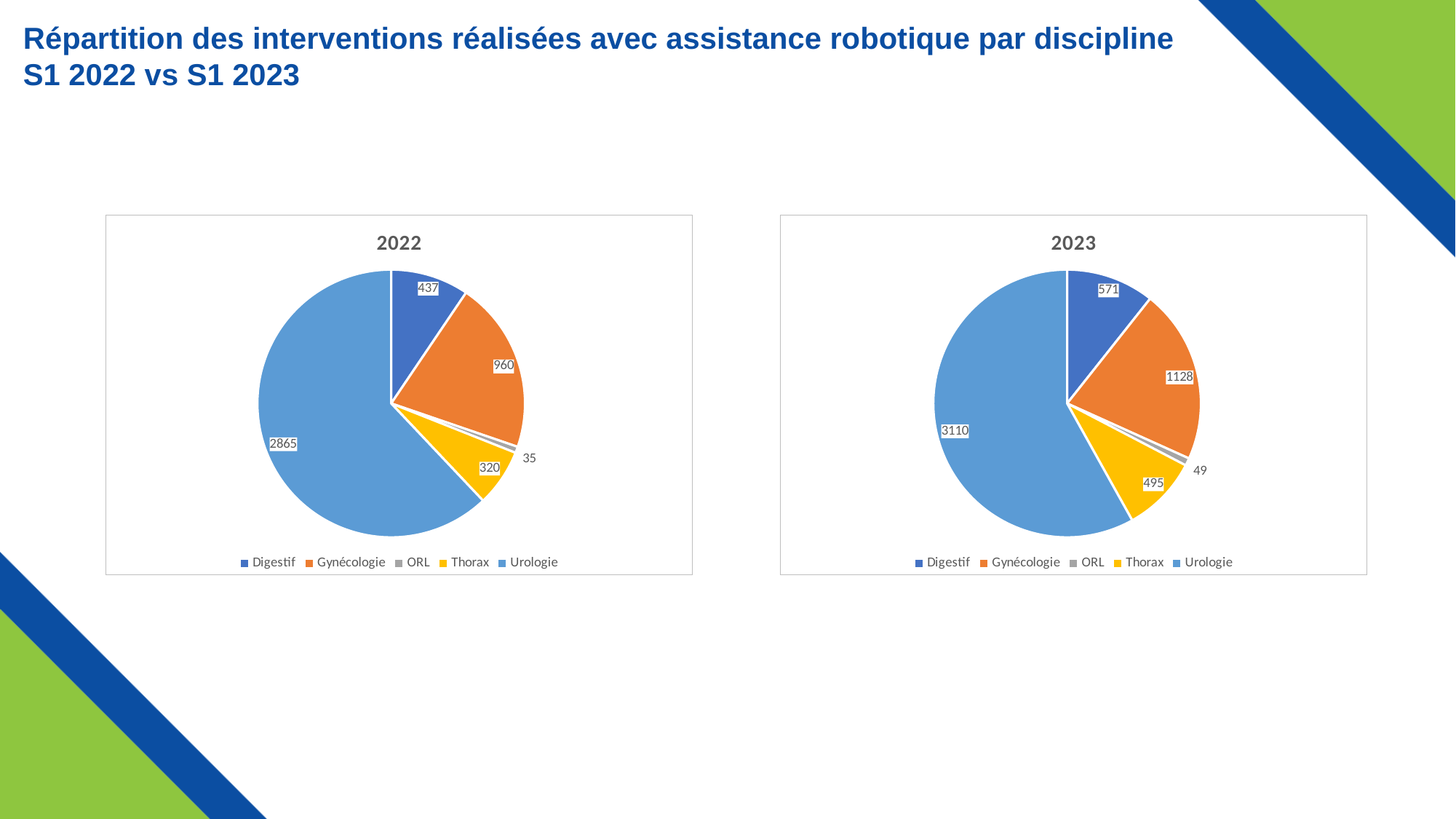
How many disciplines are shown in the 2022 pie chart? 5 In the 2023 pie chart, which discipline has the largest slice? Urologie In the 2023 pie chart, what colour represents Urologie? Light blue In the 2022 pie chart, what is the value for ORL? 35 What is the difference between the Digestif values in the 2023 and 2022 pie charts? 134 In the 2023 pie chart, what is the value for Thorax? 495 In the 2022 pie chart, what is the value for Urologie? 2865 In the 2023 pie chart, which is larger, Digestif or Thorax? Digestif In the 2022 pie chart, which discipline has the smallest slice? ORL In the 2022 pie chart, what is the difference between Gynécologie and Thorax? 640 What type of chart is used for the 2023 data? Pie chart In the 2023 pie chart, what is the value for Gynécologie? 1128